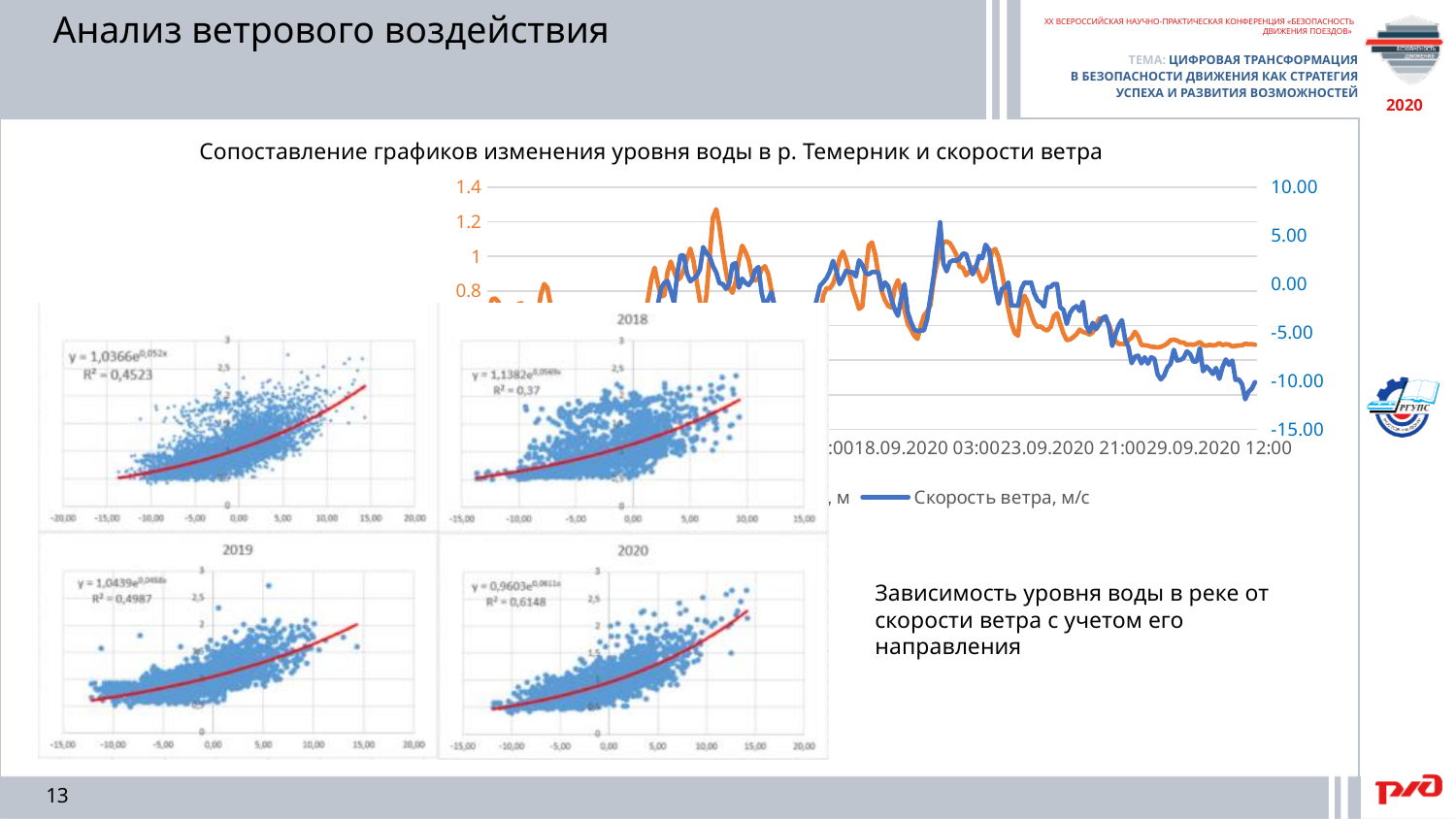
In the chart 'Сопоставление графиков изменения уровня воды в р. Темерник и скорости ветра', does the blue wind speed line rise or fall over the last part of the x axis? fall What is the R² value shown on the scatter plot titled '2020'? 0,6148 Is the R² value on the scatter plot titled '2020' larger or smaller than the R² value on the scatter plot titled '2019'? larger What is the R² value shown on the scatter plot titled '2019'? 0,4987 How many series does the legend of the chart 'Сопоставление графиков изменения уровня воды в р. Темерник и скорости ветра' list? 2 What is the R² value shown on the scatter plot in the top-left corner of the slide? 0,4523 Among the scatter plots titled '2018', '2019' and '2020', which has the lowest R² value? 2018 What is the R² value shown on the scatter plot titled '2018'? 0,37 In the chart 'Сопоставление графиков изменения уровня воды в р. Темерник и скорости ветра', what is the highest tick on the right-hand axis? 10.00 What kind of chart is the chart titled 'Сопоставление графиков изменения уровня воды в р. Темерник и скорости ветра'? line chart Among the scatter plots titled '2018', '2019' and '2020', which has the highest R² value? 2020 In the chart 'Сопоставление графиков изменения уровня воды в р. Темерник и скорости ветра', which legend entry corresponds to the blue line? Скорость ветра, м/с